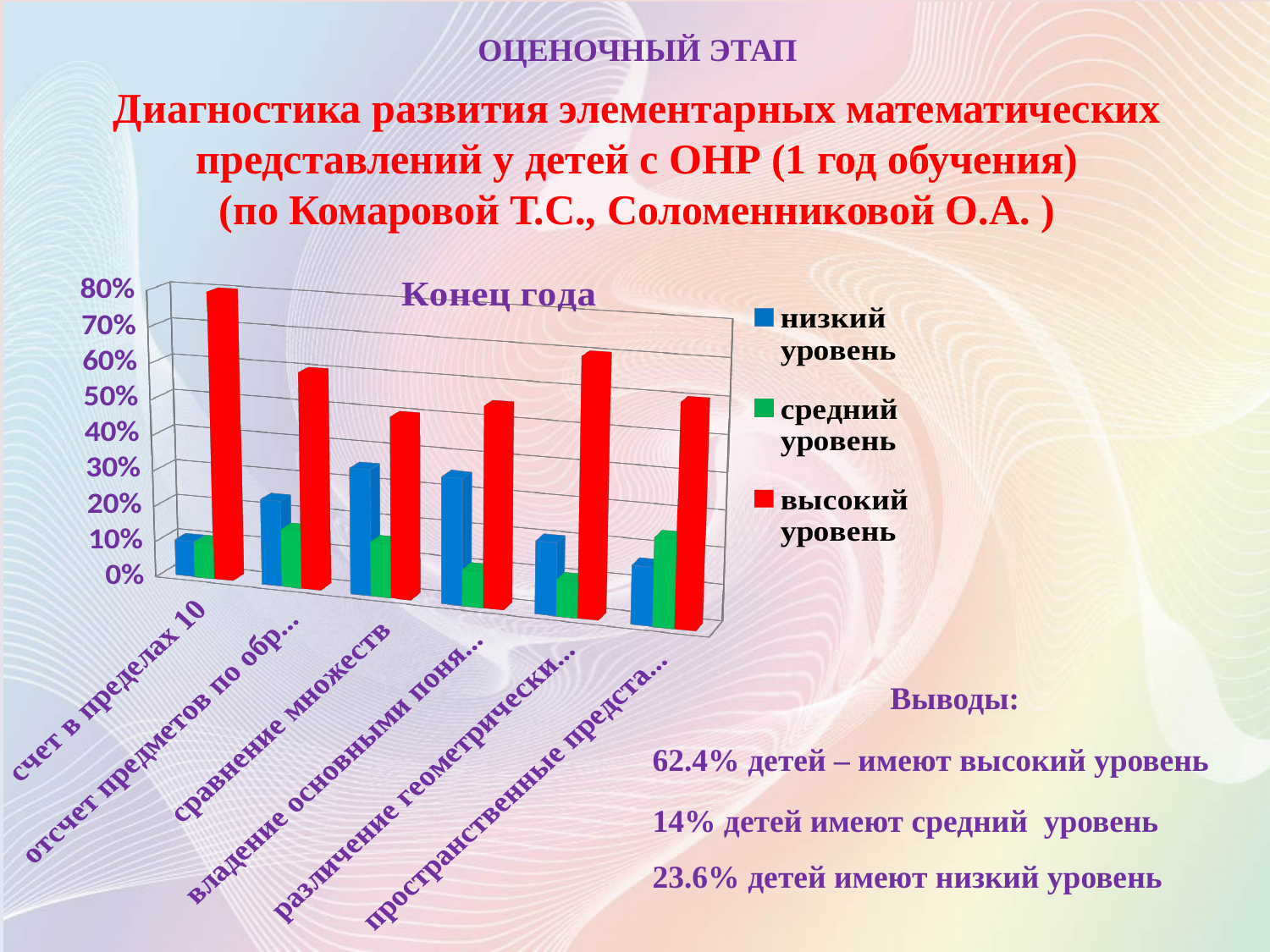
What kind of chart is shown on the slide? bar chart How many series does the chart legend list? 3 How many categories are shown along the x axis of the chart? 6 Is the value for "высокий уровень" in the category "различение геометрически..." greater or less than 50%? greater Is the value for "высокий уровень" in the category "счет в пределах 10" greater or less than 60%? greater In the category "отсчет предметов по обр...", which series has the larger value: "низкий уровень" or "высокий уровень"? высокий уровень Which category has the highest value for "высокий уровень"? счет в пределах 10 Is the value for "низкий уровень" in the category "пространственные предста..." greater or less than 10%? less Which category has the larger value for "высокий уровень": "счет в пределах 10" or "сравнение множеств"? счет в пределах 10 What is the title of the chart? Конец года Which colour represents the series "высокий уровень" in the chart? red